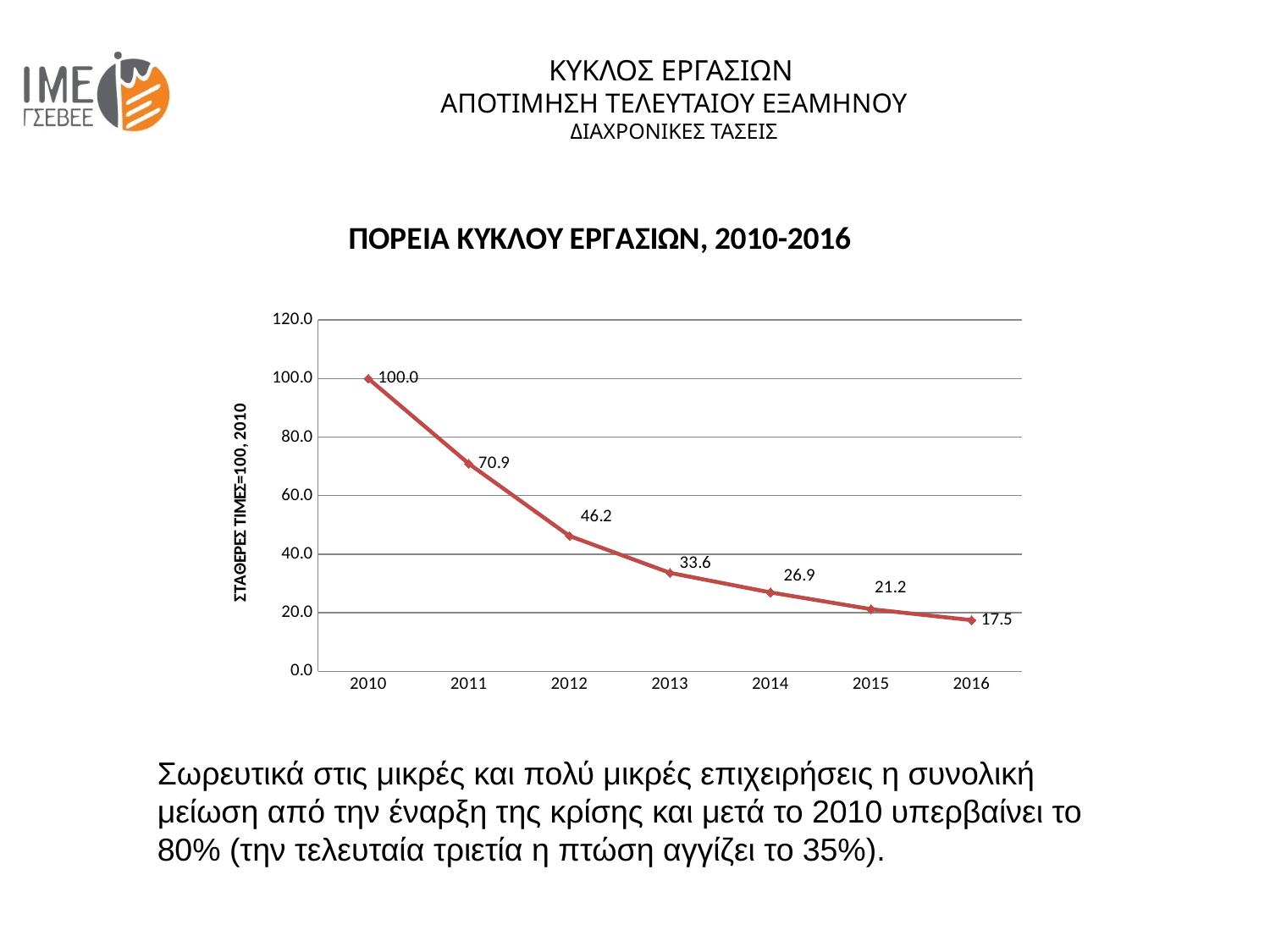
Do the values rise or fall from 2010 to 2016? fall What is the value for 2014? 26.9 What kind of chart is shown? line chart What is the value for 2016? 17.5 What is the difference between the values for 2012 and 2013? 12.6 Which year has the lowest value? 2016 Is the value for 2012 greater or less than 40.0? greater Which year has the highest value? 2010 Which is larger, the value for 2013 or the value for 2015? 2013 What is the value for 2011? 70.9 What is the difference between the values for 2010 and 2016? 82.5 How many years are plotted on the chart? 7